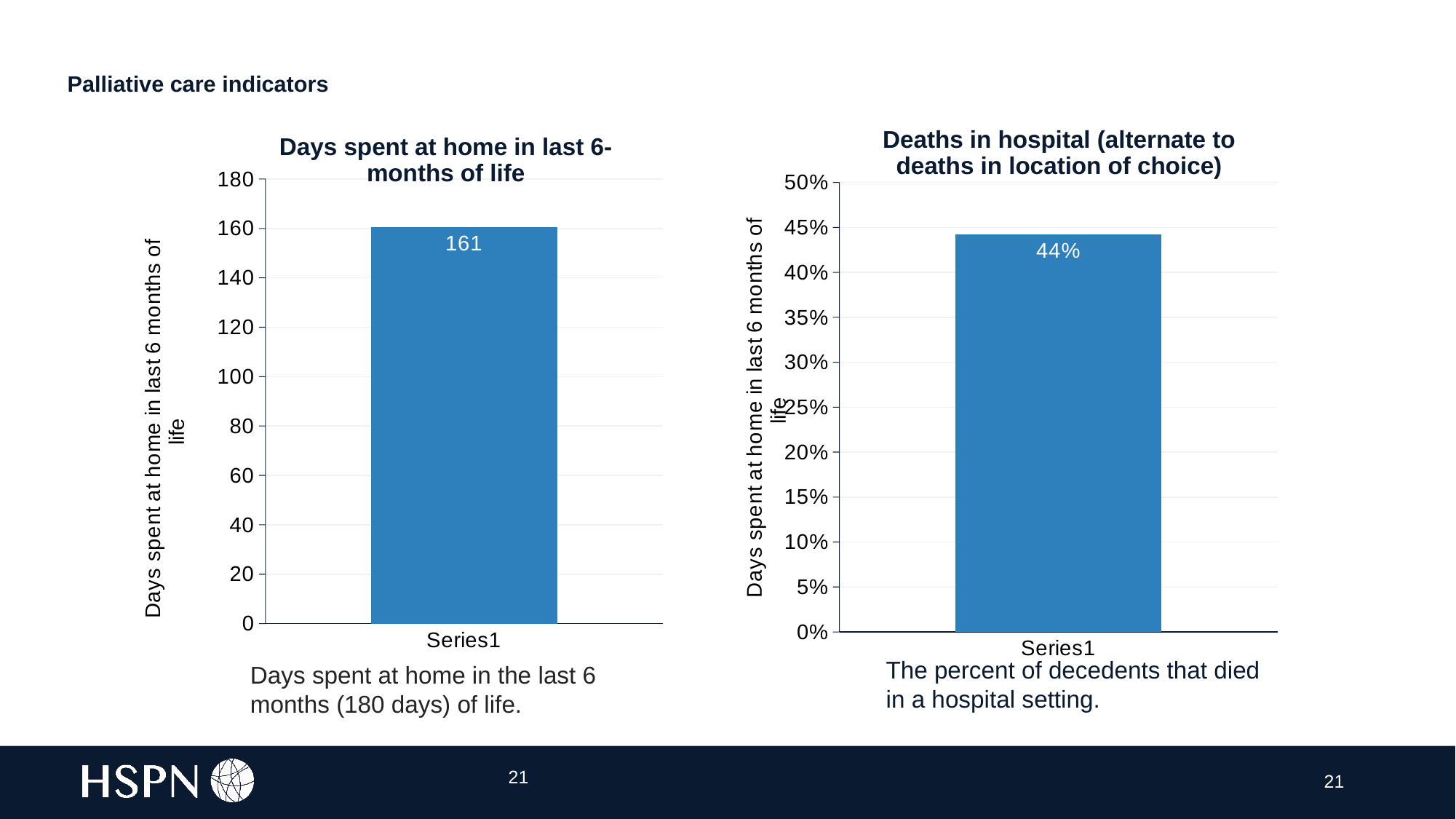
In the 'Deaths in hospital (alternate to deaths in location of choice)' chart, what is the highest value shown on the vertical axis? 50% What is the category label on the x axis of the 'Days spent at home in last 6-months of life' chart? Series1 In the 'Days spent at home in last 6-months of life' chart, what is the highest value shown on the vertical axis? 180 How many bars are plotted in the 'Days spent at home in last 6-months of life' chart? 1 How many bars are plotted in the 'Deaths in hospital (alternate to deaths in location of choice)' chart? 1 What kind of chart is the 'Deaths in hospital (alternate to deaths in location of choice)' chart? Bar chart In the 'Deaths in hospital (alternate to deaths in location of choice)' chart, is the value for Series1 greater or less than 50%? less In the 'Days spent at home in last 6-months of life' chart, is the value for Series1 greater or less than 140? greater In the 'Days spent at home in last 6-months of life' chart, what is the value shown for Series1? 161 In the 'Deaths in hospital (alternate to deaths in location of choice)' chart, what is the value shown for Series1? 44% What kind of chart is the 'Days spent at home in last 6-months of life' chart? Bar chart